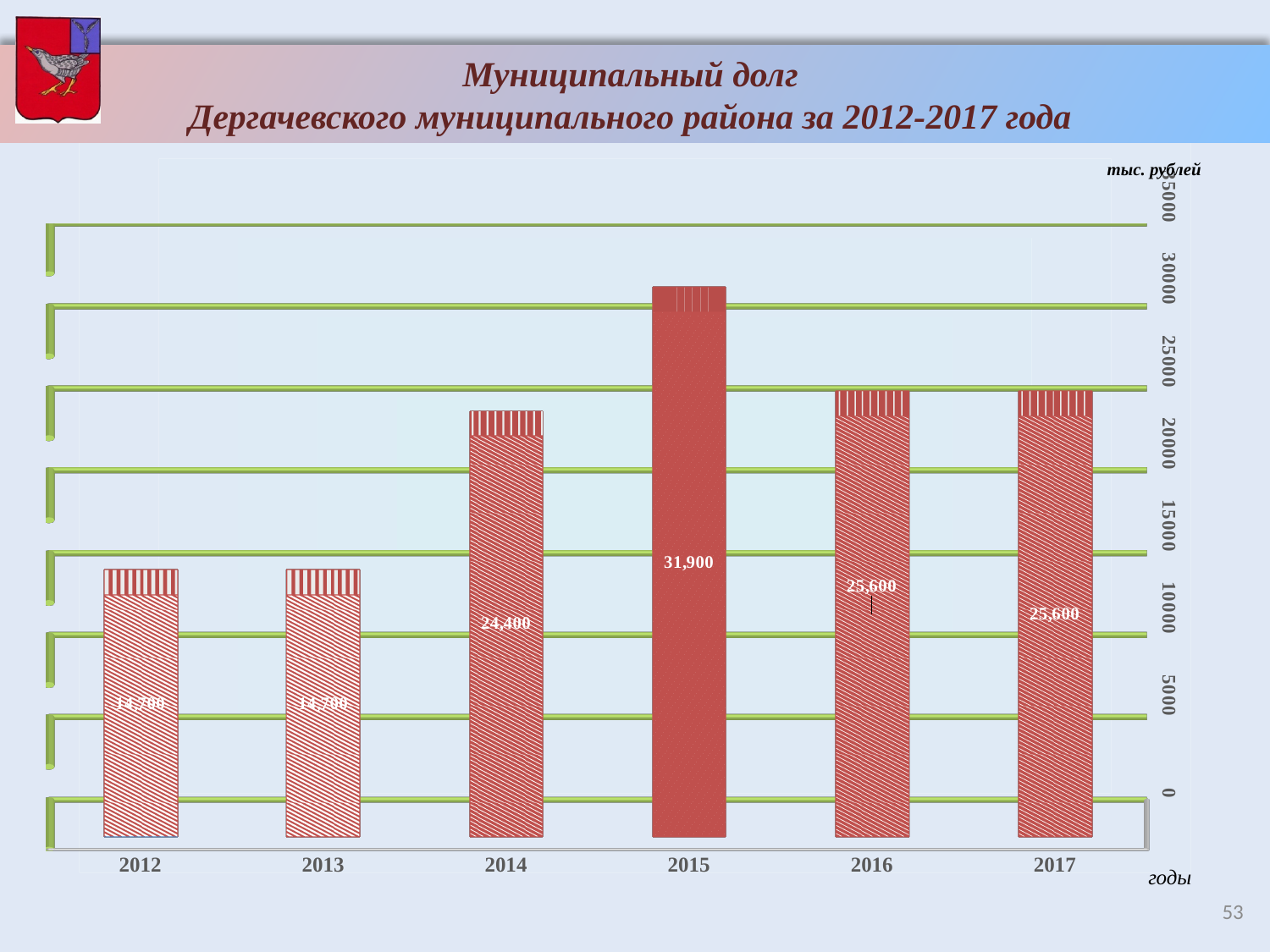
What is the difference between the values for 2015 and 2014? 7,500 How many years are shown on the x axis? 6 Is the value for 2015 greater or less than 30000? greater What unit is indicated for the values on the chart? тыс. рублей What kind of chart is shown on the slide? bar chart What is the value shown for 2014? 24,400 What is the municipal debt value shown for 2015? 31,900 What is the value shown for 2017? 25,600 Which year has the highest municipal debt? 2015 Is the value for 2013 greater or less than 15000? less Which is larger, the value for 2014 or the value for 2016? 2016 What is the difference between the values for 2016 and 2012? 10,900